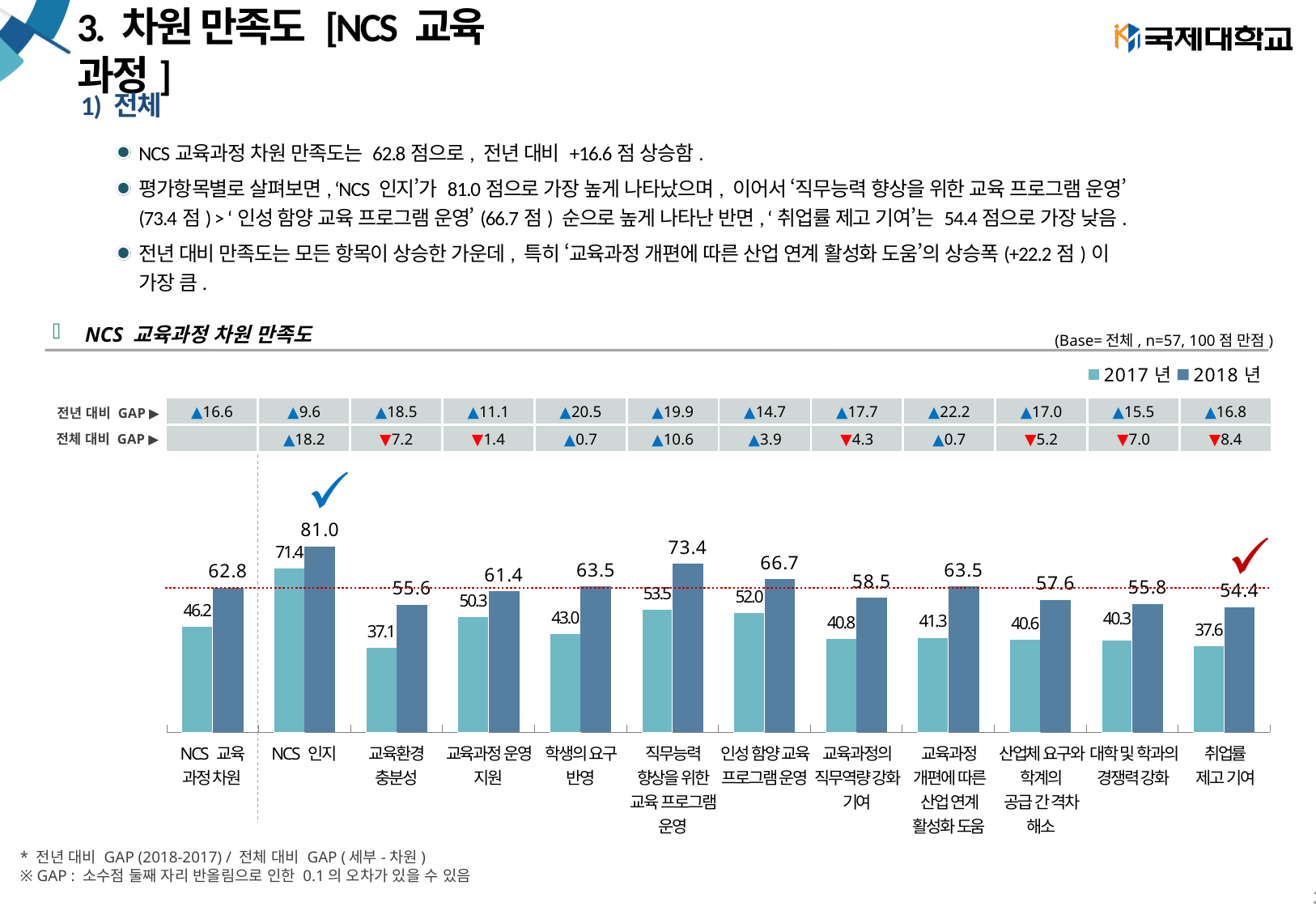
Which category has the lowest 2017 년 value? 교육환경 충분성 What is the 2017 년 value for 취업률 제고 기여? 37.6 What kind of chart is shown on the slide? bar chart How many categories are shown on the x axis of the chart? 12 What is the 2018 년 value for NCS 인지? 81.0 Which is larger, the 2018 년 value for 인성 함양 교육 프로그램 운영 or the 2018 년 value for 교육과정의 직무역량 강화 기여? 인성 함양 교육 프로그램 운영 What is the 2017 년 value for 교육과정 운영 지원? 50.3 What is the 2018 년 value for 직무능력 향상을 위한 교육 프로그램 운영? 73.4 What are the two series listed in the chart legend? 2017 년 and 2018 년 What is the difference between the 2018 년 and 2017 년 values for NCS 교육과정 차원? 16.6 How many series does the legend list? 2 Which category has the highest 2018 년 value? NCS 인지